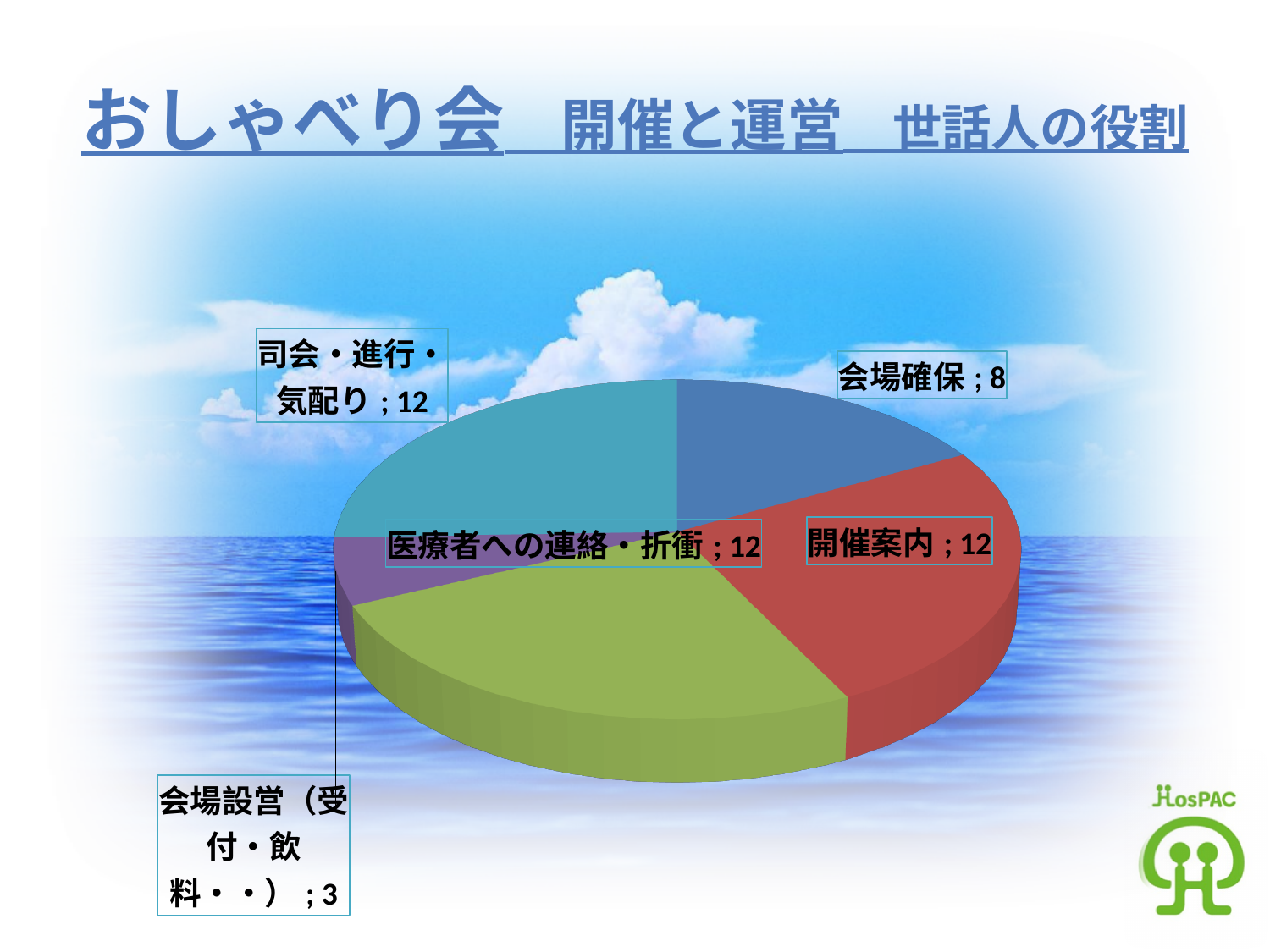
How many categories does the pie chart have? 5 What is the value for 会場設営（受付・飲料・・）? 3 What is the difference between the values for 会場確保 and 会場設営（受付・飲料・・）? 5 What is the value for 司会・進行・気配り? 12 Which is larger, the value for 会場確保 or the value for 会場設営（受付・飲料・・）? 会場確保 What kind of chart is shown on the slide? pie chart What is the value for 会場確保? 8 What is the difference between the values for 開催案内 and 会場確保? 4 What is the value for 開催案内? 12 Which category has the smallest value? 会場設営（受付・飲料・・） What is the title of the slide containing the chart? おしゃべり会 開催と運営 世話人の役割 What is the value for 医療者への連絡・折衝? 12